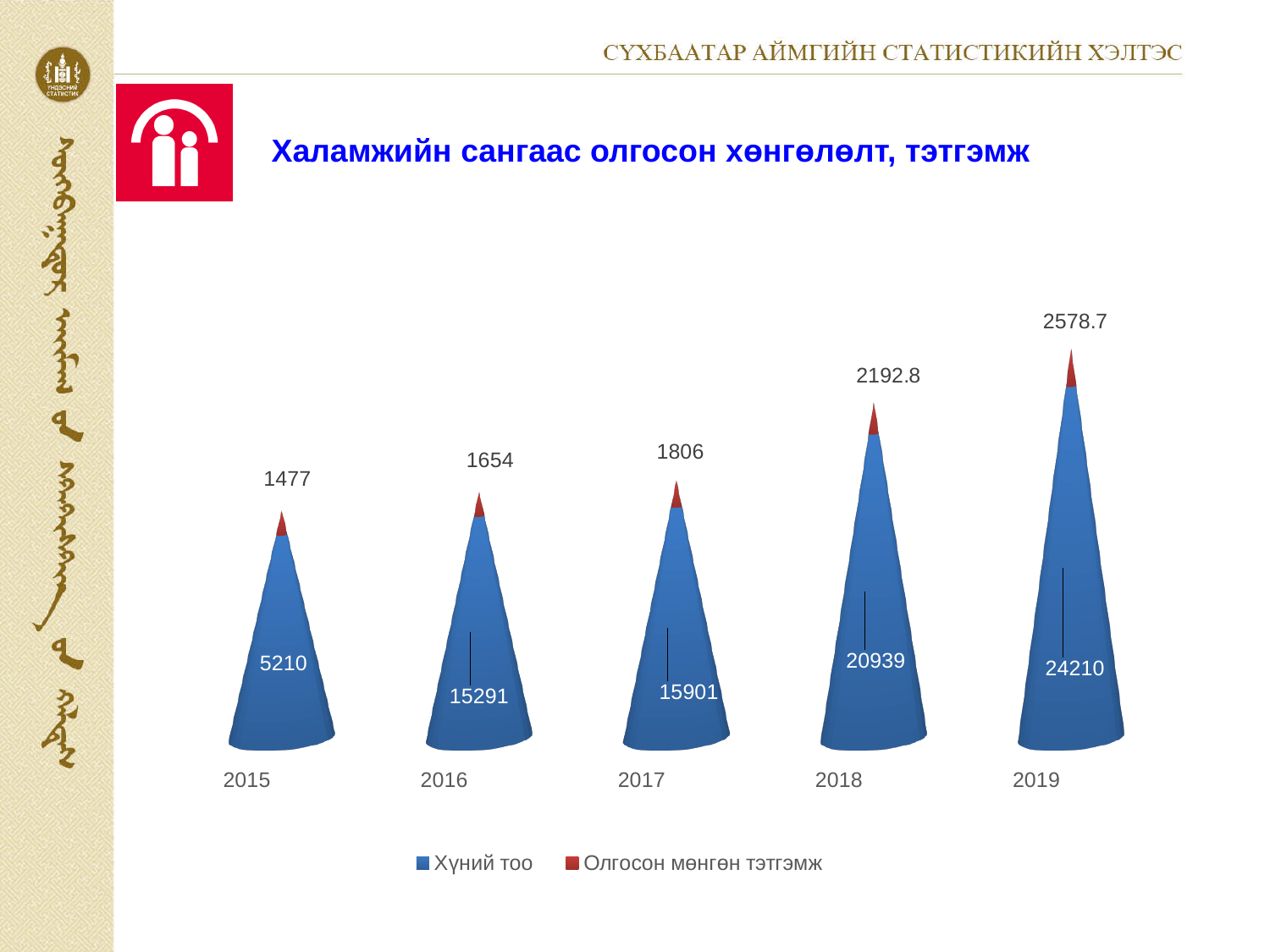
Which year has the lowest value for Олгосон мөнгөн тэтгэмж? 2015 How many series does the legend list? 2 Does the value of Хүний тоо rise or fall from 2015 to 2019? rise Which year has the highest value for Хүний тоо? 2019 How many years are shown on the x axis? 5 What is the value of Олгосон мөнгөн тэтгэмж for 2016? 1654 What is the value of Хүний тоо for 2015? 5210 Which is larger: Хүний тоо for 2016 or Хүний тоо for 2017? 2017 What is the value of Хүний тоо for 2019? 24210 What is the total of the stacked bar for 2017? 17707 What is the difference between the Хүний тоо values for 2019 and 2018? 3271 What is the value of Олгосон мөнгөн тэтгэмж for 2018? 2192.8